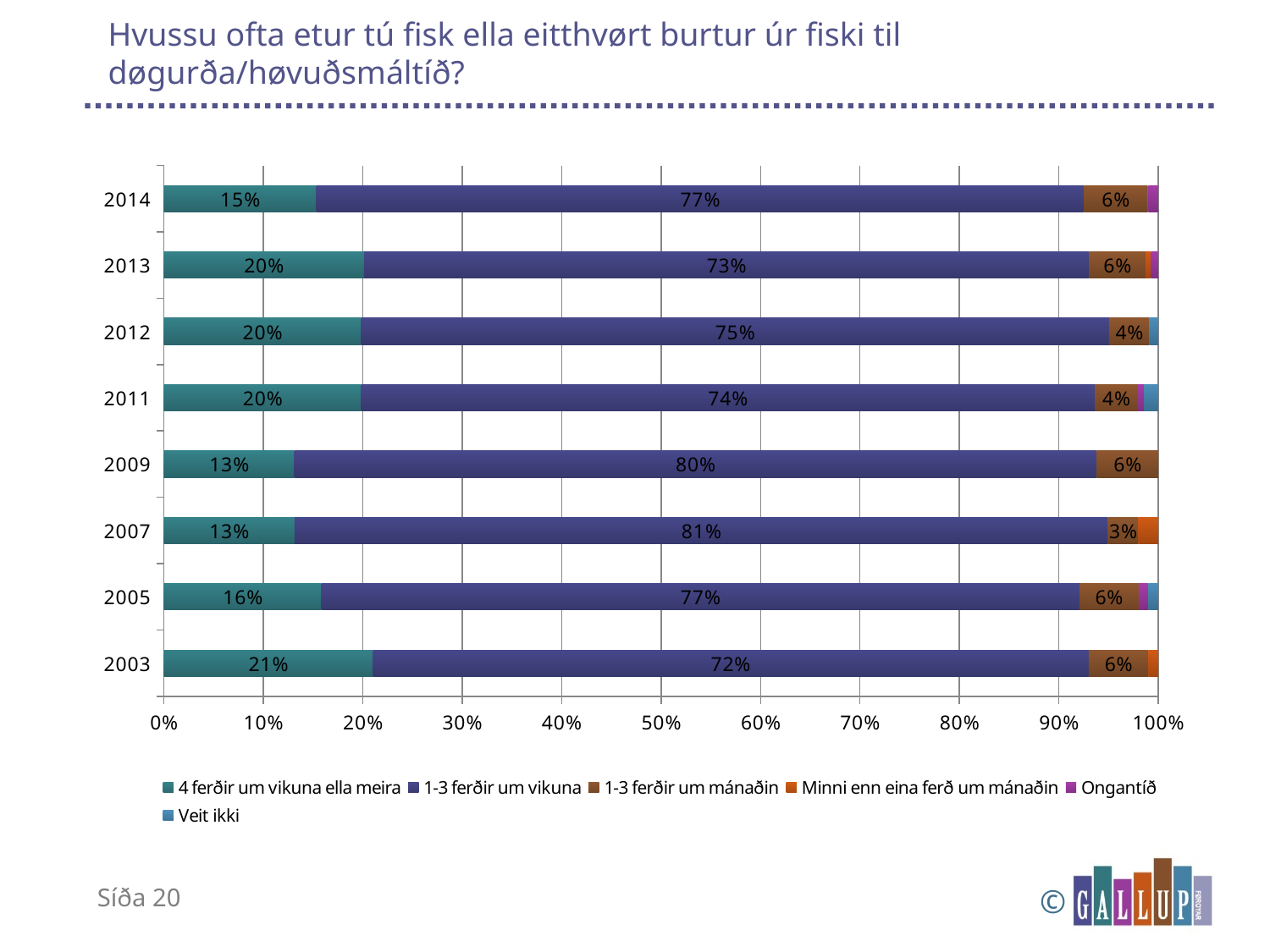
Is the "1-3 ferðir um vikuna" value for 2012 greater or less than 70%? greater How many series does the legend list? 6 What is the value for "1-3 ferðir um mánaðin" in 2007? 3% In which year is the "1-3 ferðir um vikuna" share the highest? 2007 In which year is the "4 ferðir um vikuna ella meira" share the highest? 2003 What percentage of respondents in 2014 answered "1-3 ferðir um vikuna"? 77% What kind of chart is shown on the slide? Stacked bar chart What is the value for "4 ferðir um vikuna ella meira" in 2003? 21% What is the value for "4 ferðir um vikuna ella meira" in 2009? 13% What is the difference between the "1-3 ferðir um vikuna" values for 2009 and 2003? 8% How many years are shown on the chart? 8 Which year has a larger "4 ferðir um vikuna ella meira" share, 2014 or 2013? 2013